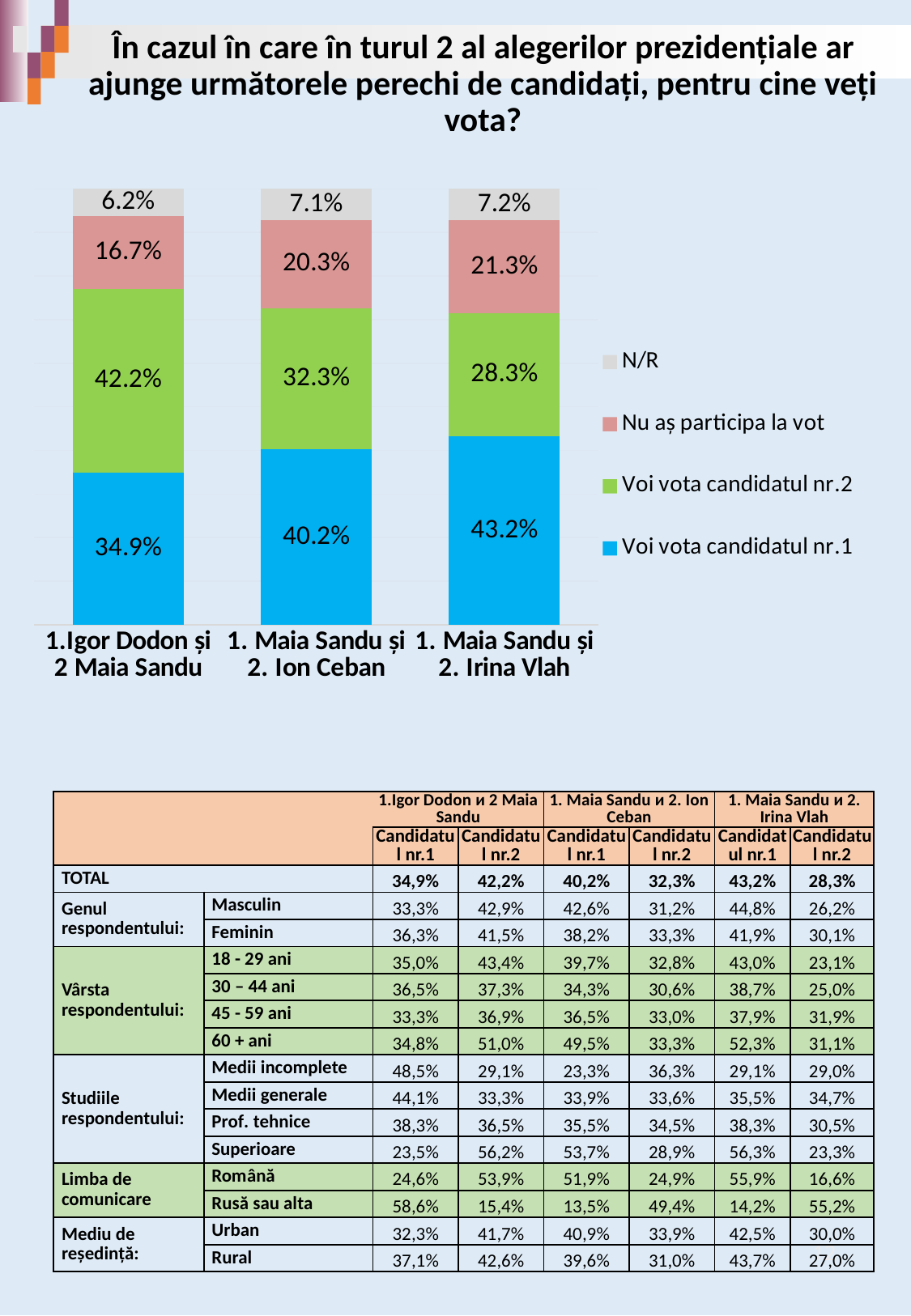
What is the N/R value for the pair '1. Maia Sandu și 2. Ion Ceban'? 7.1% Which candidate pair has the lowest N/R value? 1.Igor Dodon și 2 Maia Sandu What colour represents 'Nu aș participa la vot' in the chart? Pink How many series does the chart legend list? 4 What is the value of 'Nu aș participa la vot' for the pair '1. Maia Sandu și 2. Irina Vlah'? 21.3% What kind of chart is shown on the slide? Stacked bar chart What is the difference between 'Voi vota candidatul nr.2' and 'Voi vota candidatul nr.1' for the pair '1.Igor Dodon și 2 Maia Sandu'? 7.3% What is the value of 'Voi vota candidatul nr.2' for the pair '1. Maia Sandu și 2. Ion Ceban'? 32.3% For the pair '1. Maia Sandu și 2. Irina Vlah', which is larger: 'Voi vota candidatul nr.1' or 'Voi vota candidatul nr.2'? Voi vota candidatul nr.1 What is the value of 'Voi vota candidatul nr.1' for the pair '1.Igor Dodon și 2 Maia Sandu'? 34.9% Which candidate pair has the highest value for 'Voi vota candidatul nr.1'? 1. Maia Sandu și 2. Irina Vlah How many candidate pairs (categories) are shown in the chart? 3